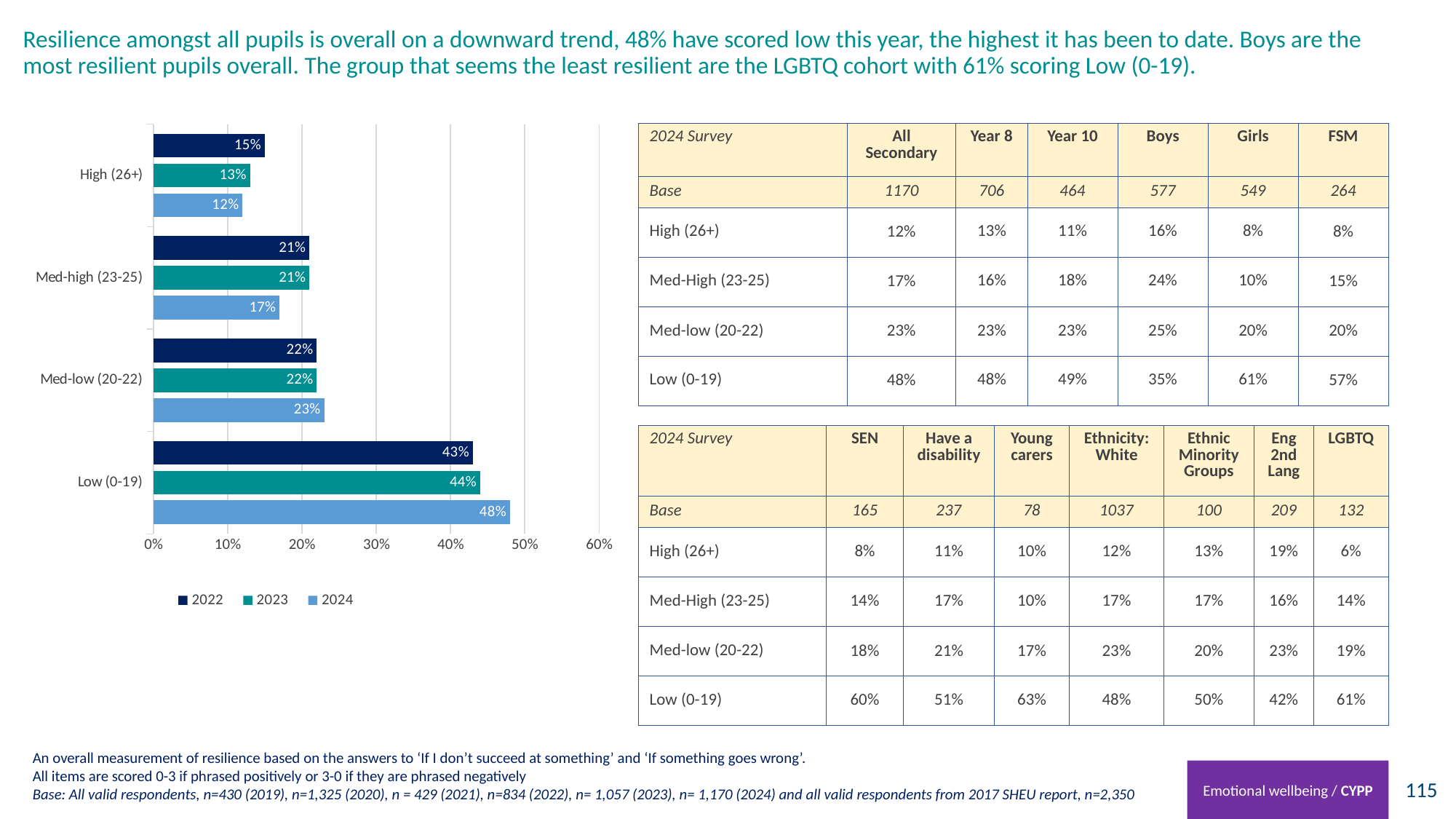
What is the value for Low (0-19) in 2024? 48% Which series is shown in the darkest blue colour in the legend? 2022 Which is larger for Med-high (23-25): the 2022 value or the 2024 value? 2022 What is the value for Med-low (20-22) in 2023? 22% Which category has the highest value for 2024? Low (0-19) How many categories are shown on the chart's vertical axis? 4 What kind of chart is shown on the slide? bar chart What is the value for High (26+) in 2022? 15% What is the value for Med-high (23-25) in 2024? 17% What is the difference between the 2024 and 2022 values for Low (0-19)? 5% How many series does the chart legend list? 3 Which category has the lowest value for 2023? High (26+)